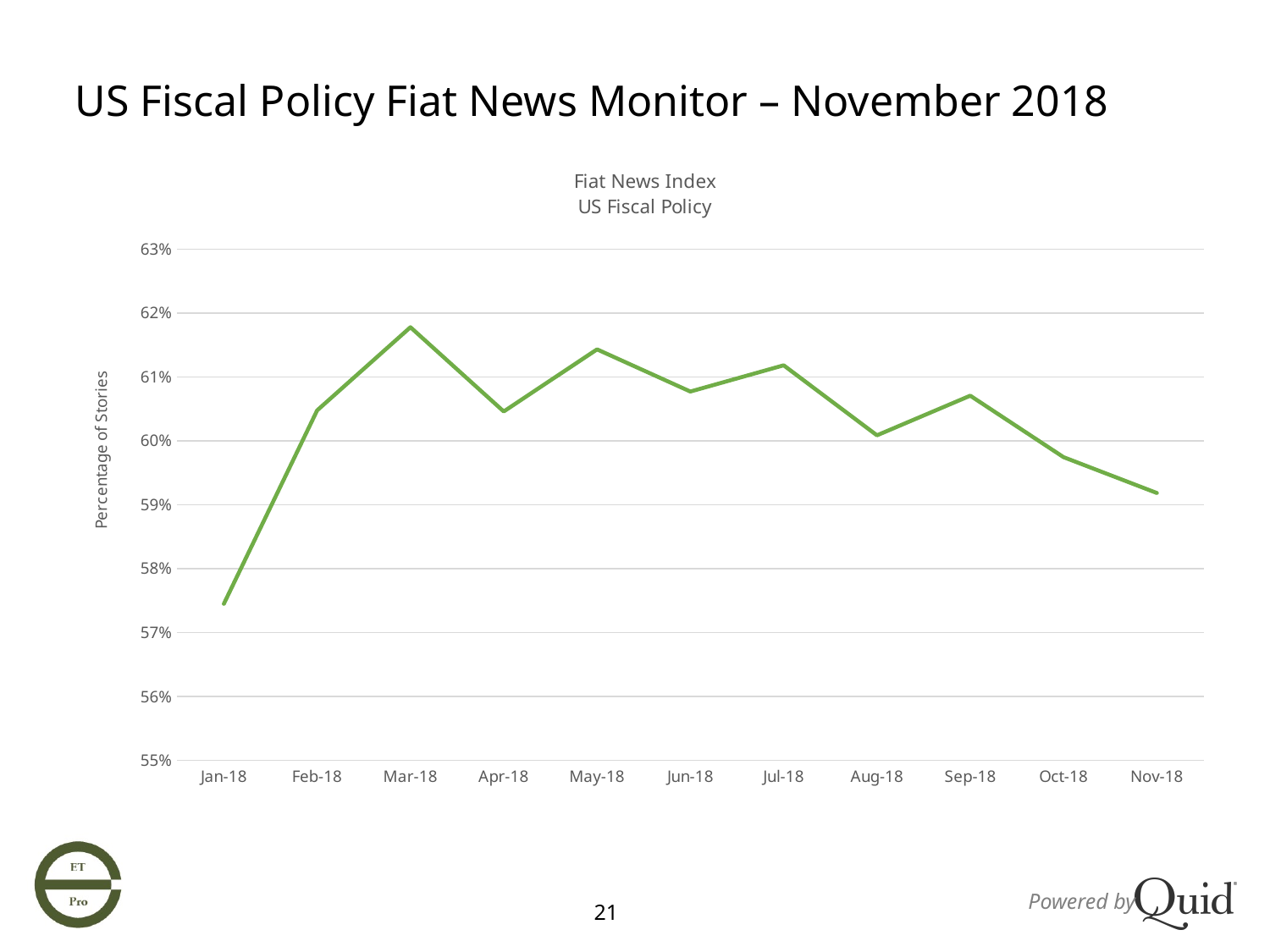
What is the label on the y axis? Percentage of Stories How many months are plotted on the x axis? 11 Is the value for Jan-18 greater or less than 58%? less Is the value for Feb-18 greater or less than 60%? greater Is the value for Mar-18 greater or less than 61%? greater Which is larger, the value for May-18 or the value for Aug-18? May-18 Do the values rise or fall from Mar-18 to Nov-18 overall? fall Which is larger, the value for Mar-18 or the value for Nov-18? Mar-18 Which month has the highest percentage of stories? Mar-18 Which month has the lowest percentage of stories? Jan-18 What kind of chart is shown on the slide? line chart